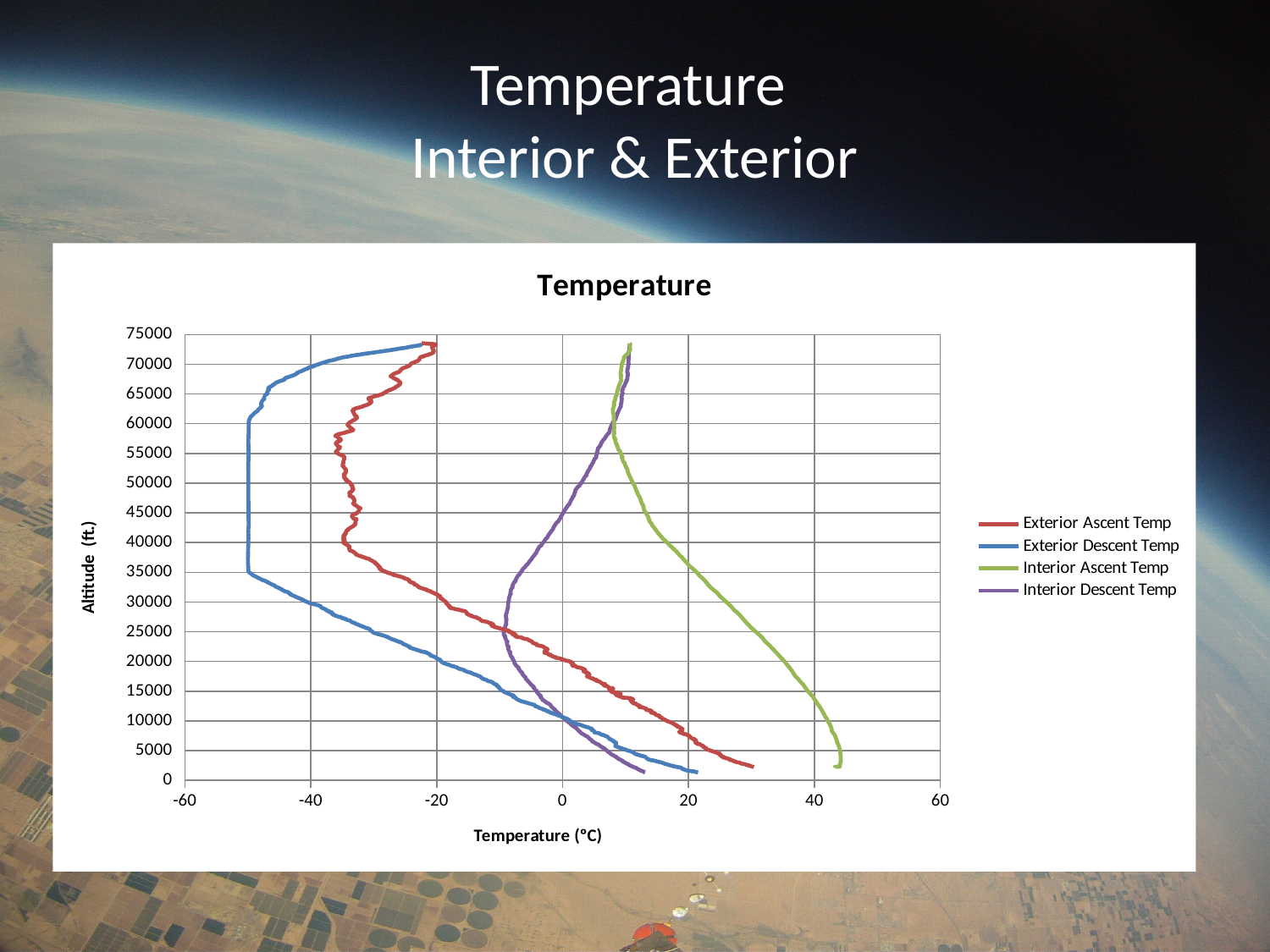
Which series reaches the highest temperature on the chart? Interior Ascent Temp Which series reaches the lowest temperature on the chart? Exterior Descent Temp Is the Interior Ascent Temp at 5000 ft greater or less than 40? greater Is the Exterior Ascent Temp at 40000 ft greater or less than -20? less Is the Exterior Descent Temp at 50000 ft greater or less than -40? less At 60000 ft, which is higher: the Exterior Ascent Temp or the Exterior Descent Temp? Exterior Ascent Temp What kind of chart is shown on the slide? line chart What is the label of the horizontal axis? Temperature (°C) How many series does the legend list? 4 What is the label of the vertical axis? Altitude (ft.) At 20000 ft, which is higher: the Interior Ascent Temp or the Exterior Ascent Temp? Interior Ascent Temp